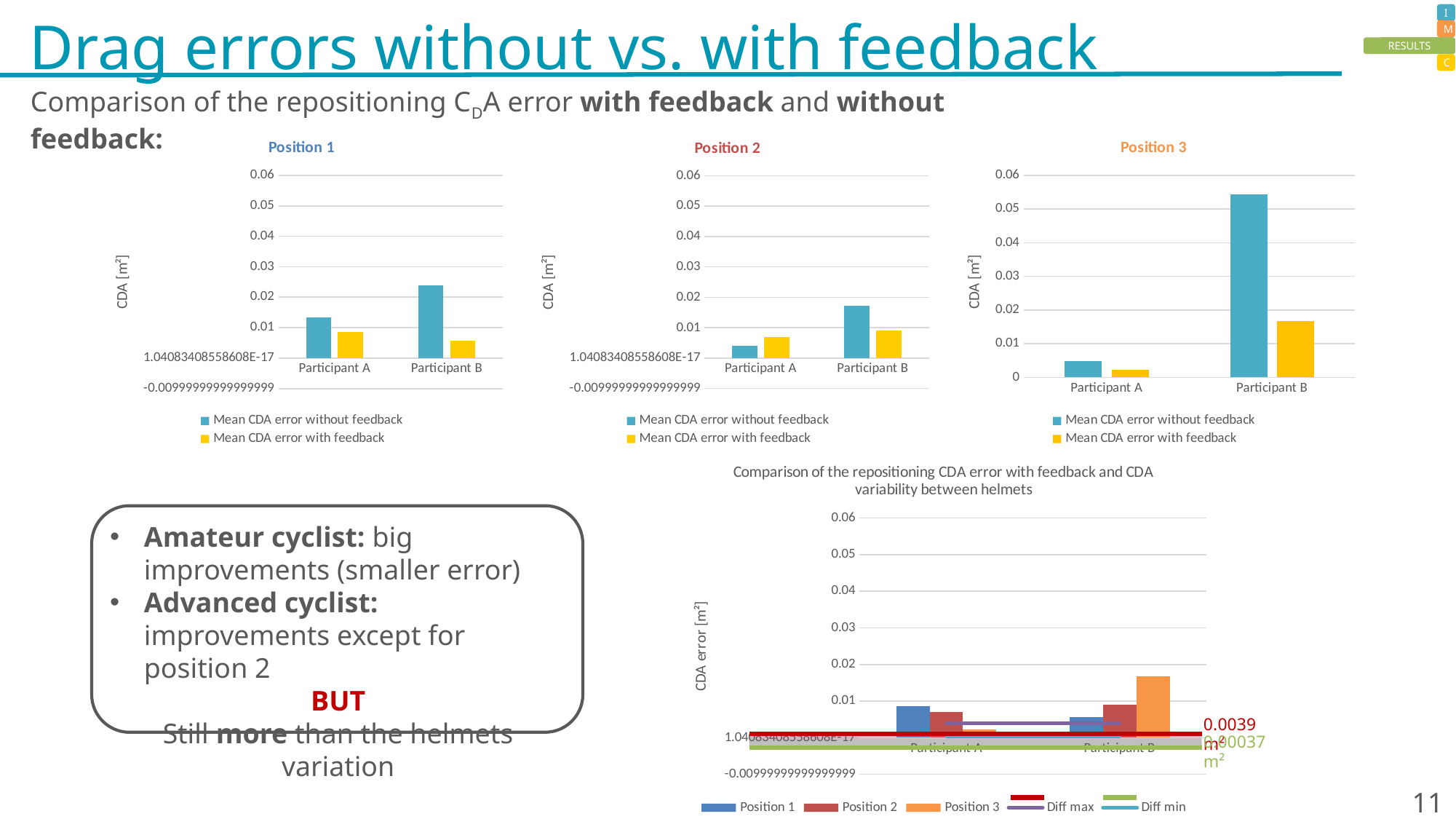
What is the y-axis label of the Position 1 chart? CDA [m²] In the Position 3 chart, which participant has the higher 'Mean CDA error without feedback'? Participant B In the bottom chart 'Comparison of the repositioning CDA error with feedback and CDA variability between helmets', which position has the lowest bar for Participant A? Position 3 In the bottom chart 'Comparison of the repositioning CDA error with feedback and CDA variability between helmets', is the Position 3 value for Participant B greater or less than 0.01? greater In the Position 3 chart, is the 'Mean CDA error without feedback' for Participant B greater or less than 0.05? greater How many entries does the legend of the bottom chart 'Comparison of the repositioning CDA error with feedback and CDA variability between helmets' list? 5 In the Position 1 chart, is the 'Mean CDA error without feedback' for Participant B greater or less than 0.02? greater In the Position 1 chart, for Participant B, which is larger: the mean CDA error without feedback or with feedback? without feedback In the bottom chart 'Comparison of the repositioning CDA error with feedback and CDA variability between helmets', which position has the highest bar for Participant B? Position 3 In the Position 2 chart, for Participant A, which is larger: the mean CDA error without feedback or with feedback? with feedback How many series does the legend of the Position 1 chart list? 2 What kind of chart is the Position 2 chart? bar chart